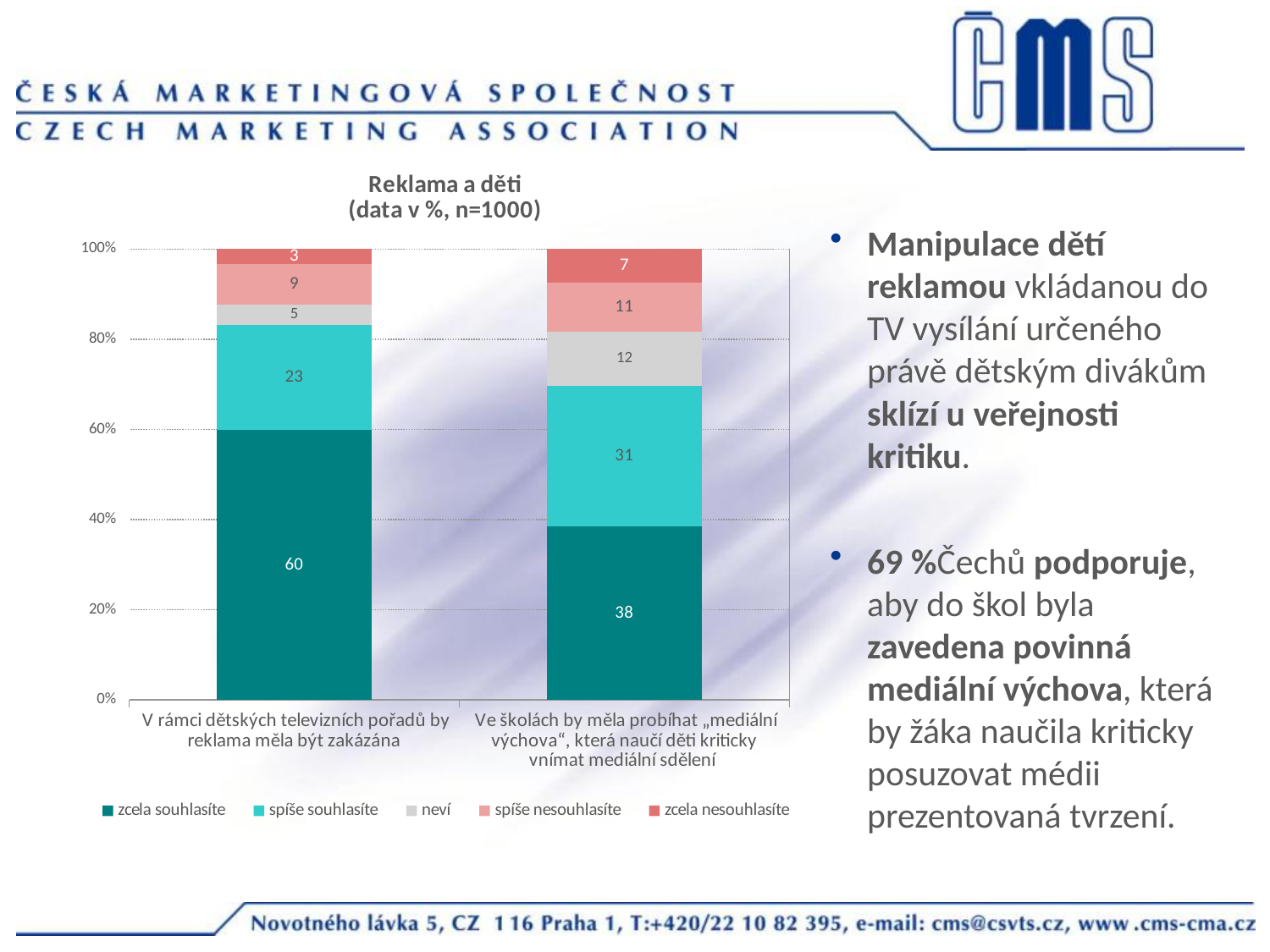
What is the value of "neví" for the category "Ve školách by měla probíhat „mediální výchova“"? 12 What is the value of "spíše souhlasíte" for the category "Ve školách by měla probíhat „mediální výchova“"? 31 What is the value of "zcela souhlasíte" for the category "Ve školách by měla probíhat „mediální výchova“"? 38 What is the title of the chart? Reklama a děti (data v %, n=1000) What is the value of "zcela nesouhlasíte" for the category "V rámci dětských televizních pořadů by reklama měla být zakázána"? 3 Which category has the higher "spíše nesouhlasíte" value? Ve školách by měla probíhat „mediální výchova“ How many series does the legend list? 5 What is the total of the stacked bar for "V rámci dětských televizních pořadů by reklama měla být zakázána"? 100 What is the difference between the "zcela souhlasíte" values of the two categories? 22 How many categories are shown on the x axis? 2 What kind of chart is shown on the slide? stacked bar chart What is the value of "zcela souhlasíte" for the category "V rámci dětských televizních pořadů by reklama měla být zakázána"? 60